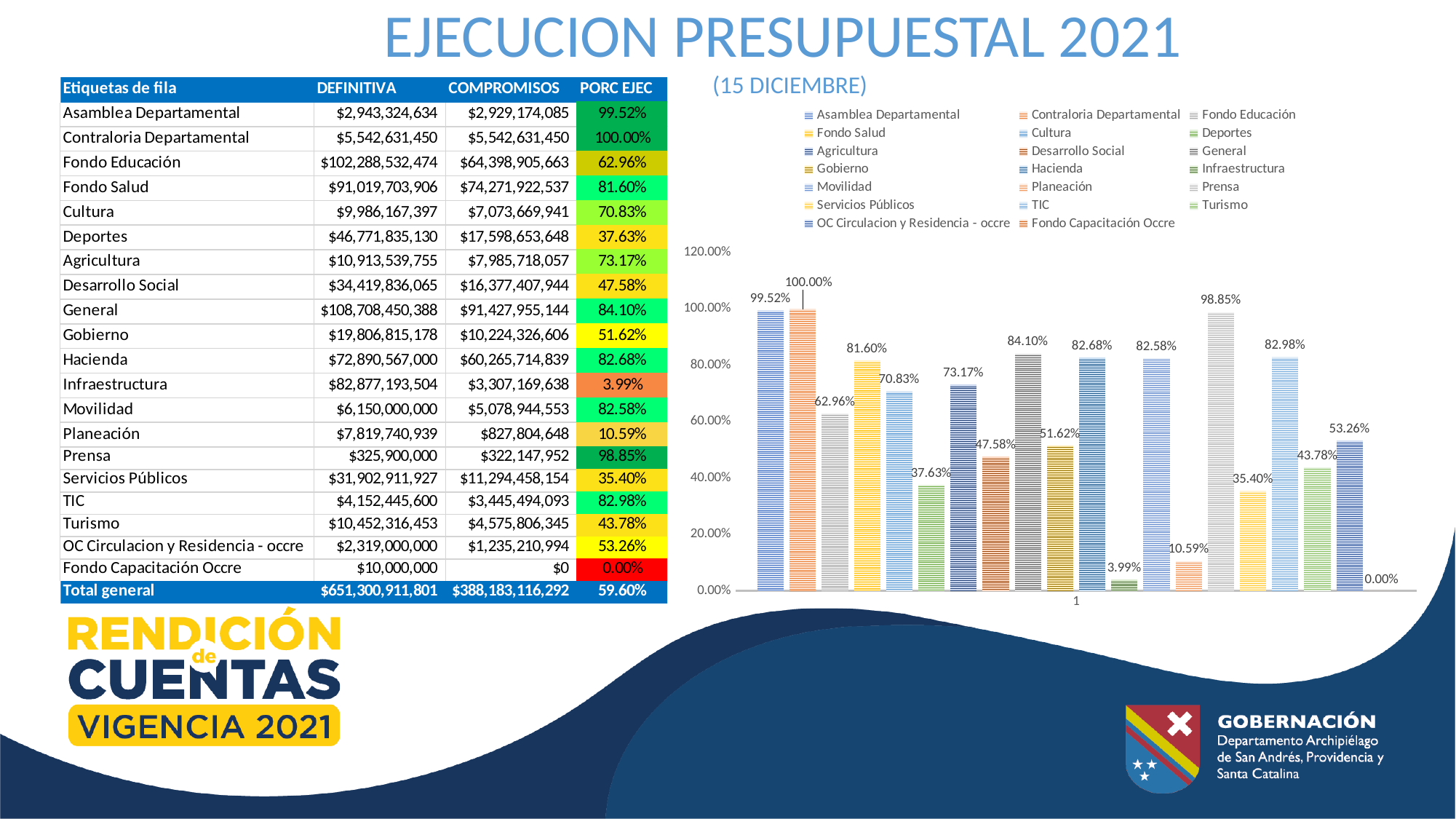
What is the value shown for Prensa in the chart? 98.85% What is the difference between the values for Fondo Salud and Deportes in the chart? 43.97% Which series has the highest value in the chart? Contraloria Departamental Which is larger in the chart, the value for General or the value for Hacienda? General What kind of chart is shown on the slide? bar chart What is the value shown for Turismo in the chart? 43.78% What is the value shown for Infraestructura in the chart? 3.99% Is the value for Servicios Públicos in the chart greater or less than 40.00%? less What is the value shown for Contraloria Departamental in the chart? 100.00% What is the value shown for Planeación in the chart? 10.59% Which series has the lowest value in the chart? Fondo Capacitación Occre How many series does the chart legend list? 20